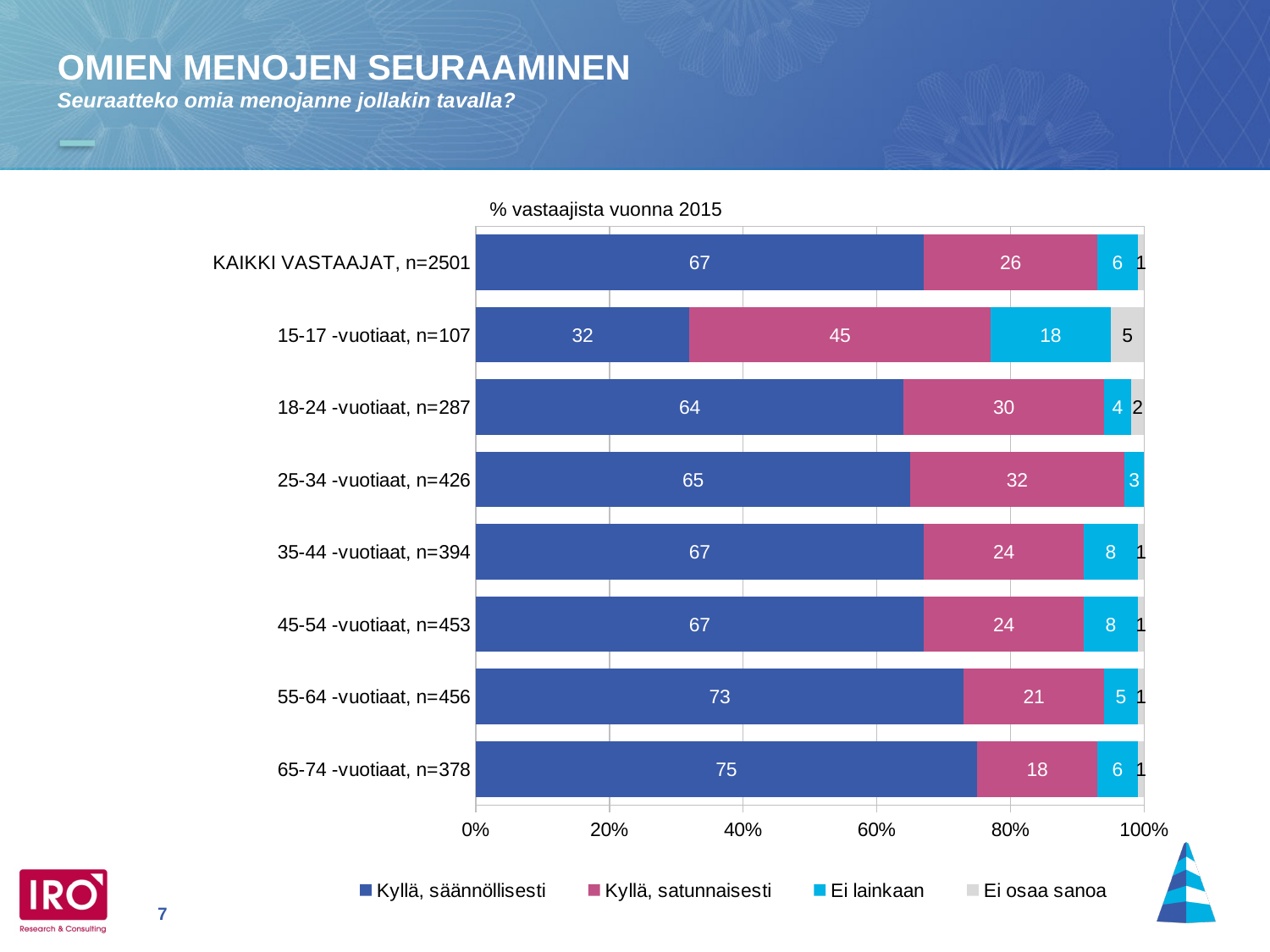
How many series does the legend list? 4 What is the title shown above the chart? % vastaajista vuonna 2015 What kind of chart is shown on the slide? Stacked bar chart Which group has the lowest value for 'Kyllä, säännöllisesti'? 15-17 -vuotiaat, n=107 Which is larger: the 'Kyllä, satunnaisesti' value for 18-24 -vuotiaat, n=287 or for 55-64 -vuotiaat, n=456? 18-24 -vuotiaat, n=287 What is the value of 'Kyllä, satunnaisesti' for 15-17 -vuotiaat, n=107? 45 What is the total of the stacked bar for 15-17 -vuotiaat, n=107? 100 What is the value of 'Kyllä, säännöllisesti' for KAIKKI VASTAAJAT, n=2501? 67 What is the difference between the 'Kyllä, säännöllisesti' values for 65-74 -vuotiaat, n=378 and 15-17 -vuotiaat, n=107? 43 What is the value of 'Ei lainkaan' for 35-44 -vuotiaat, n=394? 8 Which group has the highest value for 'Kyllä, säännöllisesti'? 65-74 -vuotiaat, n=378 How many respondent groups (categories) are plotted on the chart? 8